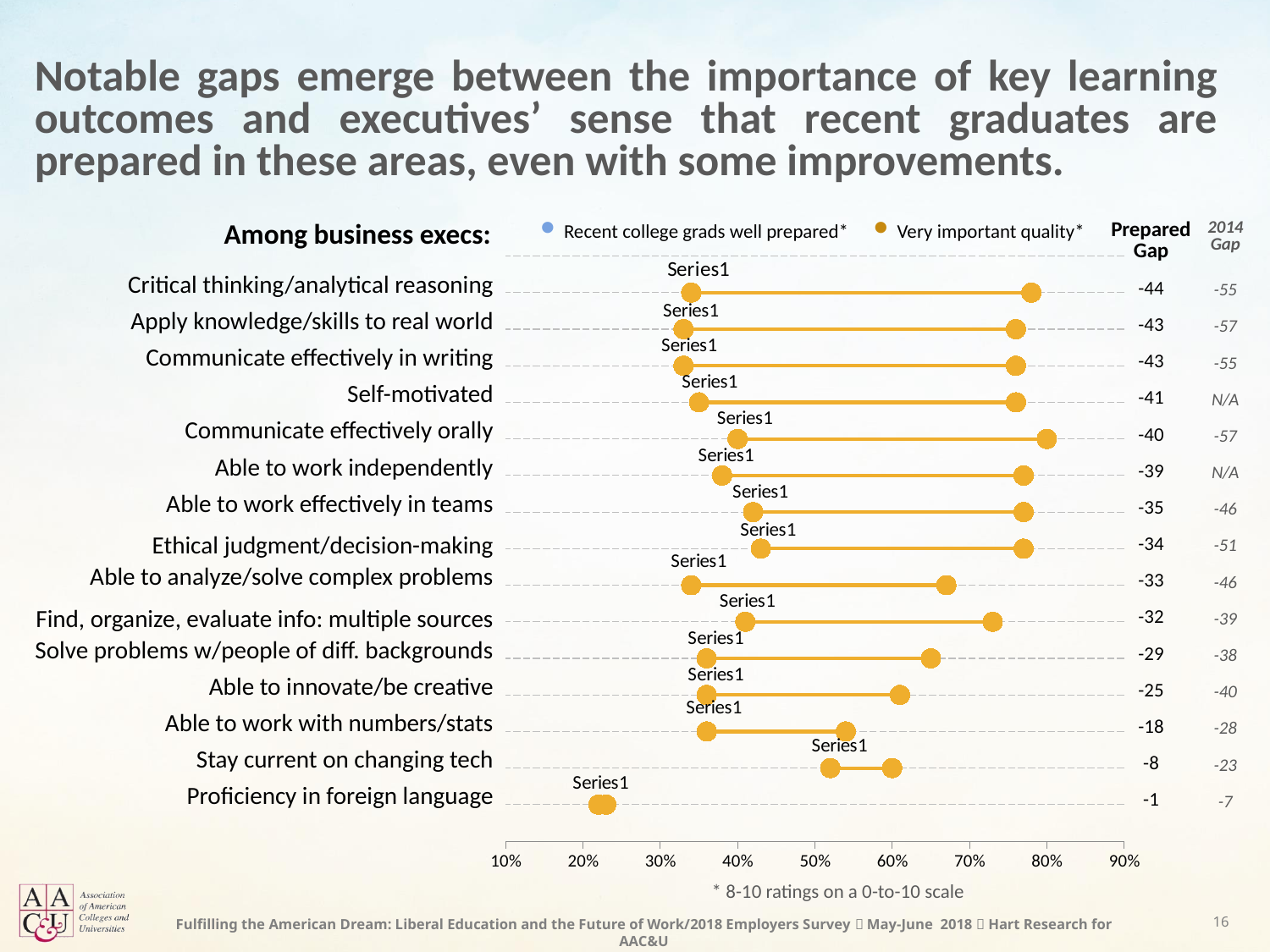
Which of the two legend series is shown in the darker gold colour? Very important quality* How many series does the chart legend list? 2 Which category has the smallest Prepared Gap? Proficiency in foreign language What is the Prepared Gap shown for Critical thinking/analytical reasoning? -44 How many learning outcome categories are plotted on the chart? 15 What is the Prepared Gap shown for Able to work with numbers/stats? -18 What is the 2014 Gap shown for Communicate effectively orally? -57 Which category has the largest Prepared Gap? Critical thinking/analytical reasoning What is the difference between the Prepared Gap for Self-motivated and the Prepared Gap for Able to work effectively in teams? 6 What kind of chart is shown on the slide? Dot plot (dumbbell chart) Is the 'Recent college grads well prepared' value for Critical thinking/analytical reasoning greater or less than 40%? less Is the 'Very important quality' value for Able to analyze/solve complex problems greater or less than 60%? greater